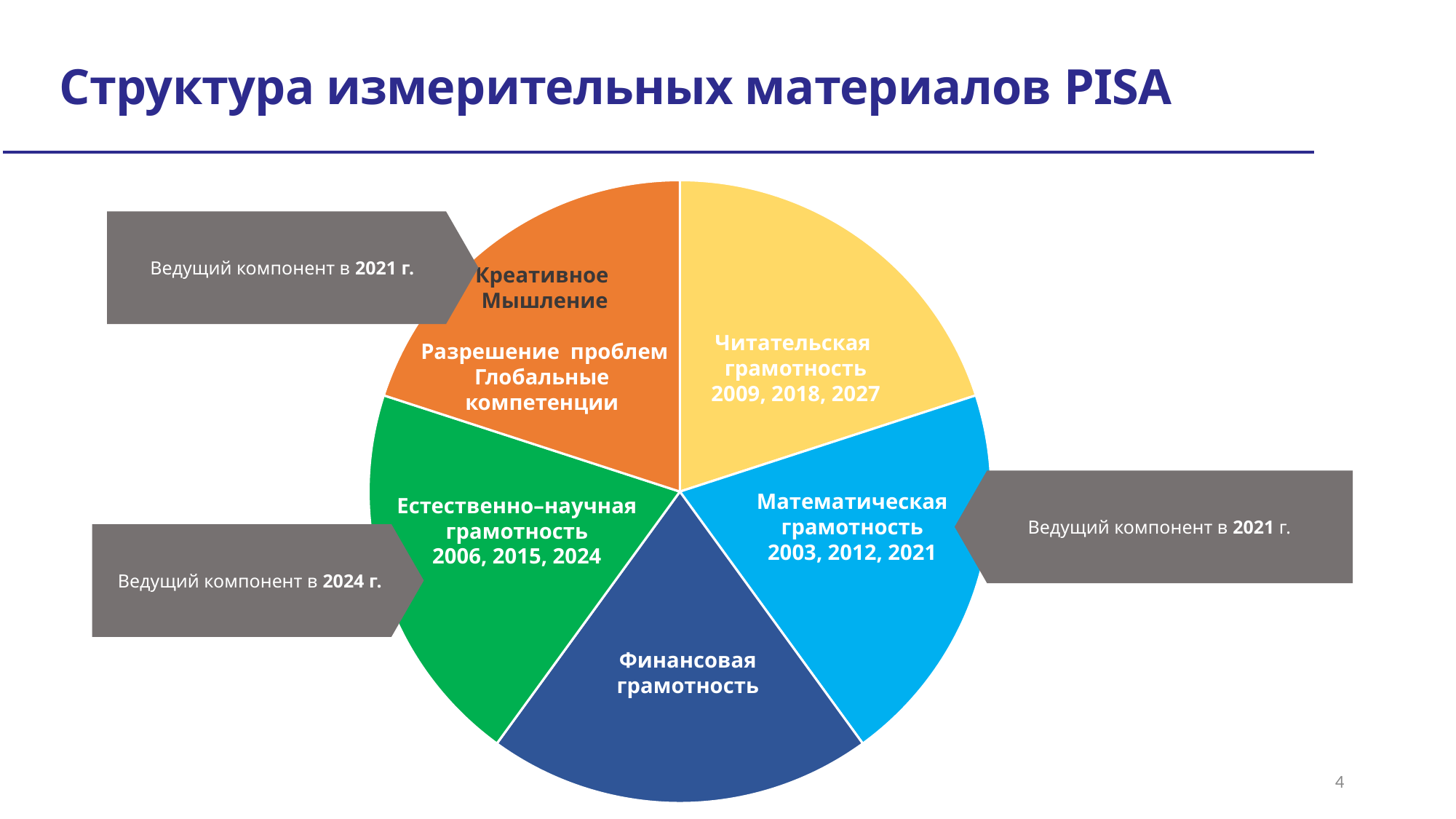
Which slice of the pie chart carries the labels "Креативное мышление", "Разрешение проблем" and "Глобальные компетенции"? The orange slice Which years are listed on the slice labelled "Читательская грамотность"? 2009, 2018, 2027 Which slice of the pie chart is coloured green? Естественно-научная грамотность Which years are listed on the slice labelled "Естественно-научная грамотность"? 2006, 2015, 2024 According to the callout next to the green slice, in which year is "Естественно-научная грамотность" the leading component? 2024 What is the title of the slide containing the pie chart? Структура измерительных материалов PISA According to the callout next to the light blue slice, in which year is "Математическая грамотность" the leading component? 2021 Which years are listed on the slice labelled "Математическая грамотность"? 2003, 2012, 2021 What kind of chart is shown on the slide? Pie chart What colour is the slice labelled "Финансовая грамотность"? Dark blue Which slice of the pie chart is coloured yellow? Читательская грамотность How many slices does the pie chart have? 5